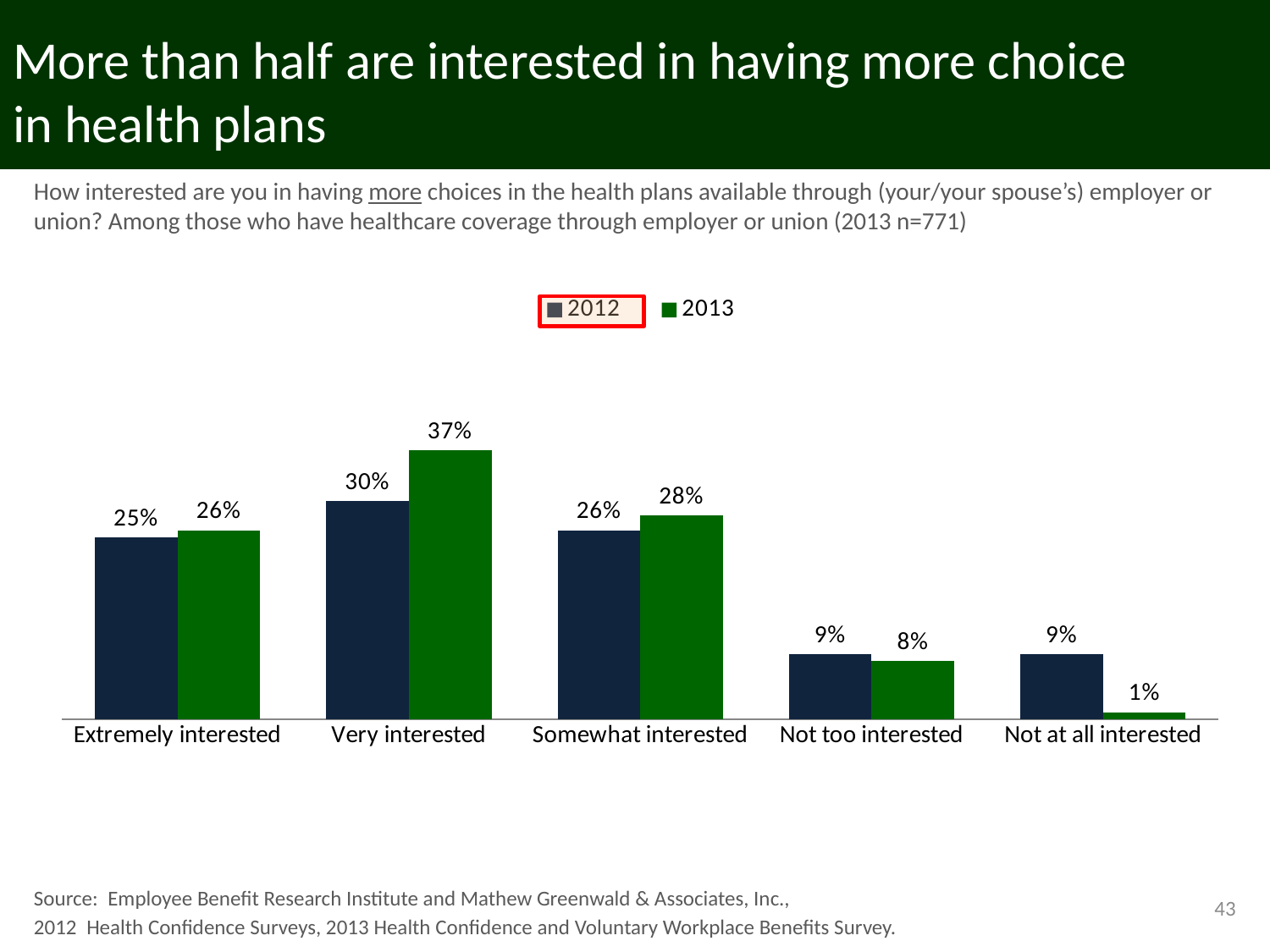
What percentage were 'Somewhat interested' in 2012? 26% Which category has the highest value for 2013? Very interested What percentage were 'Not at all interested' in 2012? 9% What is the difference between the 2013 and 2012 values for 'Very interested'? 7 percentage points Which is larger for 'Not too interested': the 2012 value or the 2013 value? 2012 How many series does the legend list? 2 What percentage were 'Very interested' in 2013? 37% What kind of chart is shown on the slide? Bar chart Which category has the lowest value for 2013? Not at all interested Which series is shown in green in the legend? 2013 How many response categories are shown on the x axis? 5 What is the difference between the 2012 and 2013 values for 'Not at all interested'? 8 percentage points